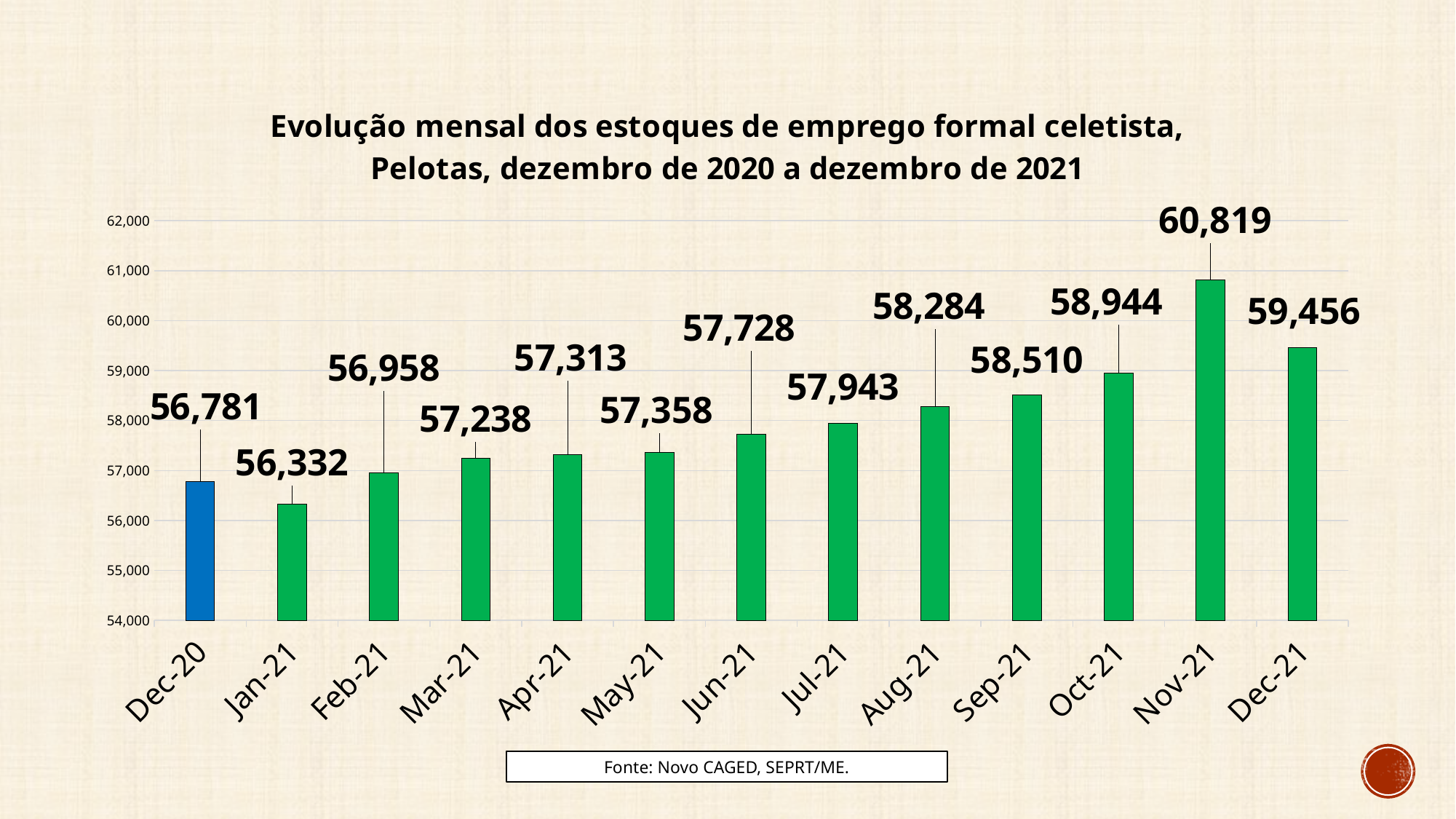
Which month has the highest value? Nov-21 What is the difference between the values for Dec-21 and Dec-20? 2,675 How many months are shown on the x axis? 13 What type of chart is shown on the slide? Bar chart Which bar is shown in a different colour (blue) from the others? Dec-20 What is the value for Dec-20? 56,781 What is the difference between the values for Nov-21 and Dec-21? 1,363 Which is larger, the value for Aug-21 or the value for Sep-21? Sep-21 What is the value for Jul-21? 57,943 Is the value for Oct-21 greater or less than 58,000? greater Which month has the lowest value? Jan-21 What is the value for Nov-21? 60,819